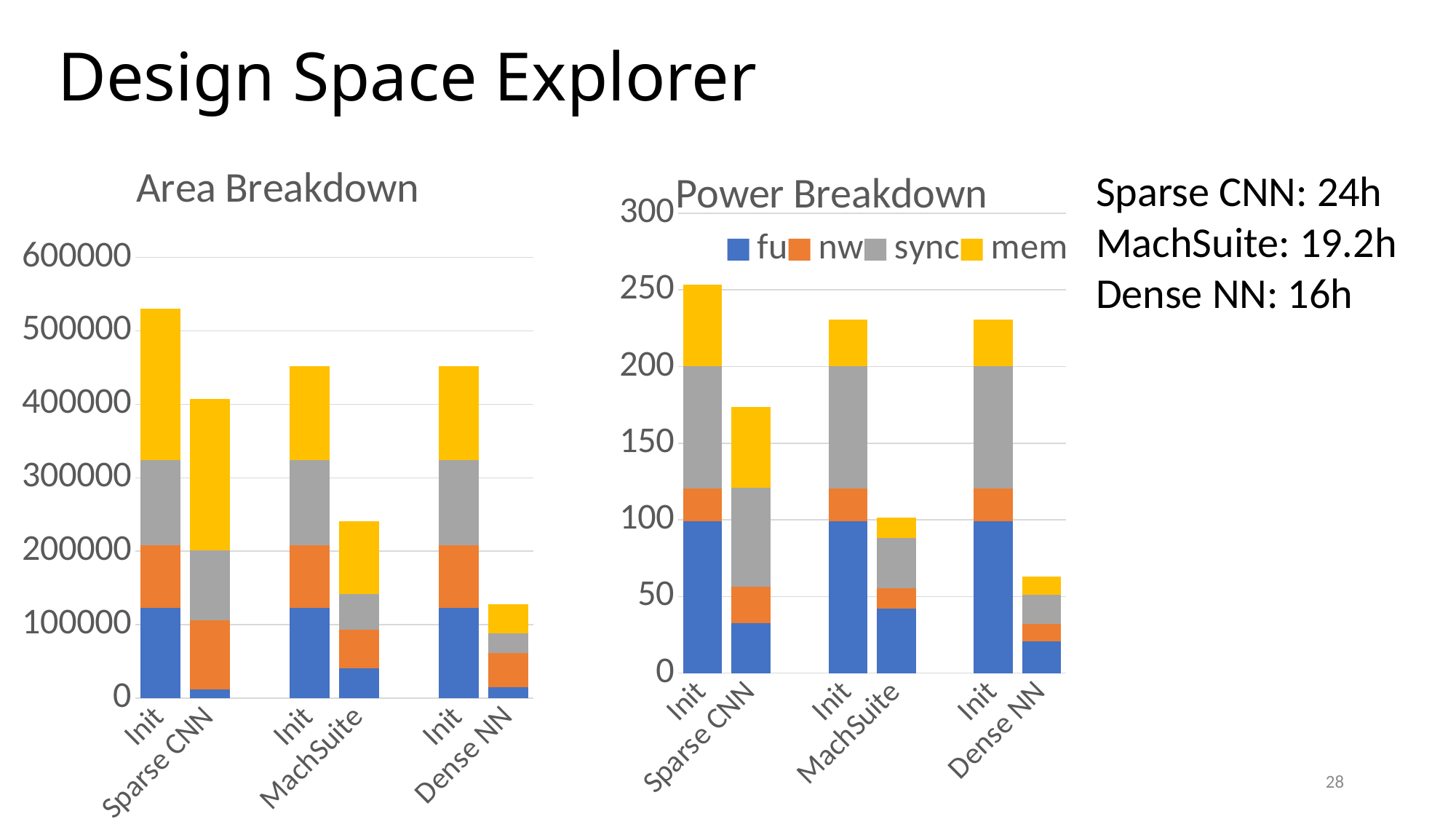
What kind of chart is the Area Breakdown chart? stacked bar chart In the Power Breakdown chart, is the total for Sparse CNN greater or less than 150? greater In the Area Breakdown chart, is the total for MachSuite greater or less than 300000? less In the Area Breakdown chart, is the total for the Init bar next to Sparse CNN greater or less than 500000? greater How many series does the legend of the Power Breakdown chart list? 4 How many bars are plotted in the Power Breakdown chart? 6 In the Power Breakdown chart, which bar is the shortest? Dense NN In the Area Breakdown chart, which bar is the tallest? Init (Sparse CNN) In the Area Breakdown chart, which bar is the shortest? Dense NN What are the legend entries of the Power Breakdown chart? fu, nw, sync, mem In the Power Breakdown chart, which is larger, the total for Sparse CNN or the total for MachSuite? Sparse CNN